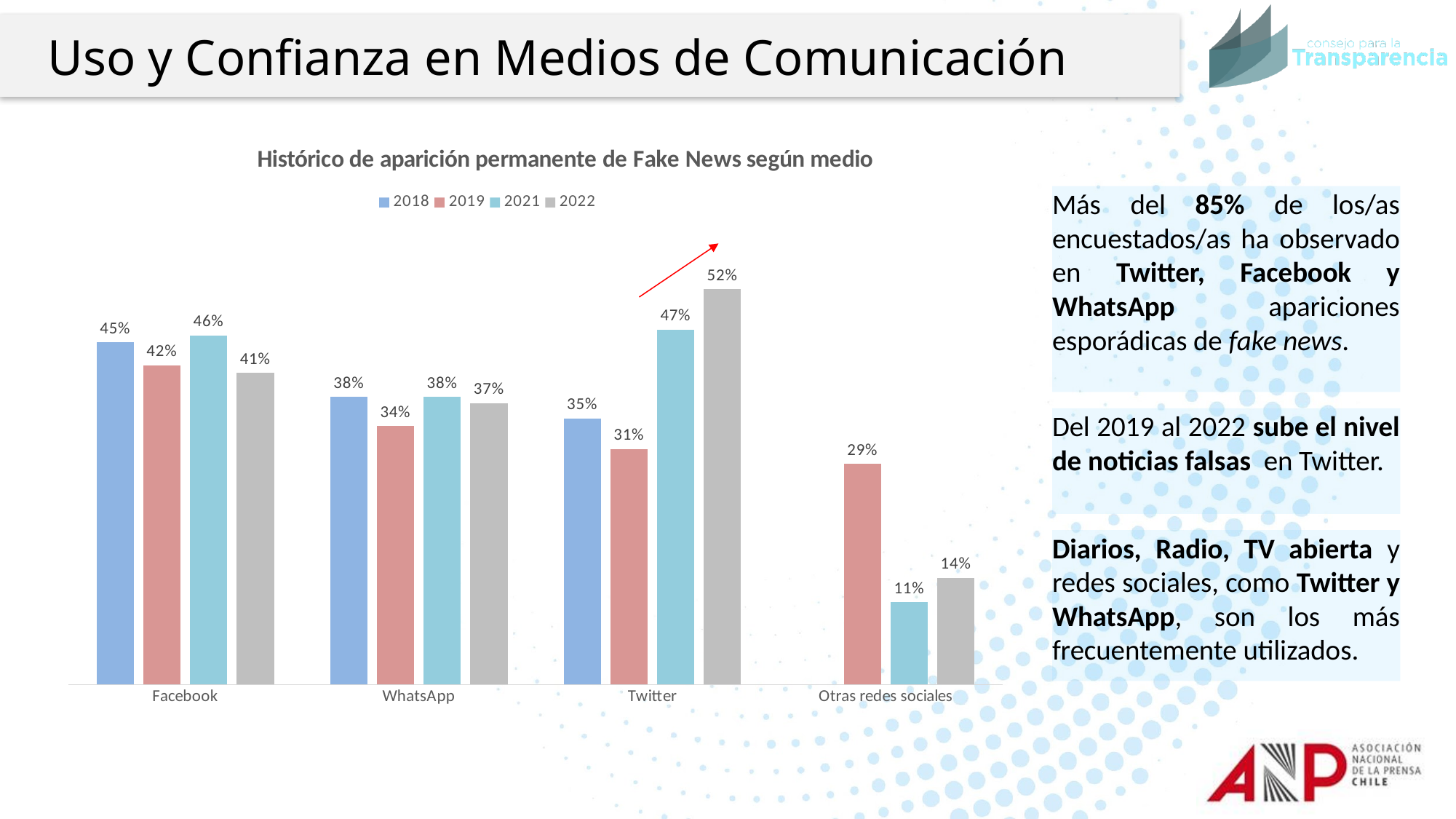
What kind of chart is shown on the slide? Bar chart What is the value for Twitter in 2022? 52% Which is larger, the 2018 value for Facebook or the 2018 value for WhatsApp? Facebook Which category has the highest 2022 value? Twitter What is the value for Facebook in 2019? 42% How many categories are shown on the x axis? 4 What is the title of the chart? Histórico de aparición permanente de Fake News según medio Which category has the lowest 2021 value? Otras redes sociales What is the value for Otras redes sociales in 2019? 29% How many series does the legend list? 4 What is the value for WhatsApp in 2021? 38% What is the difference between the 2022 and 2019 values for Twitter? 21%